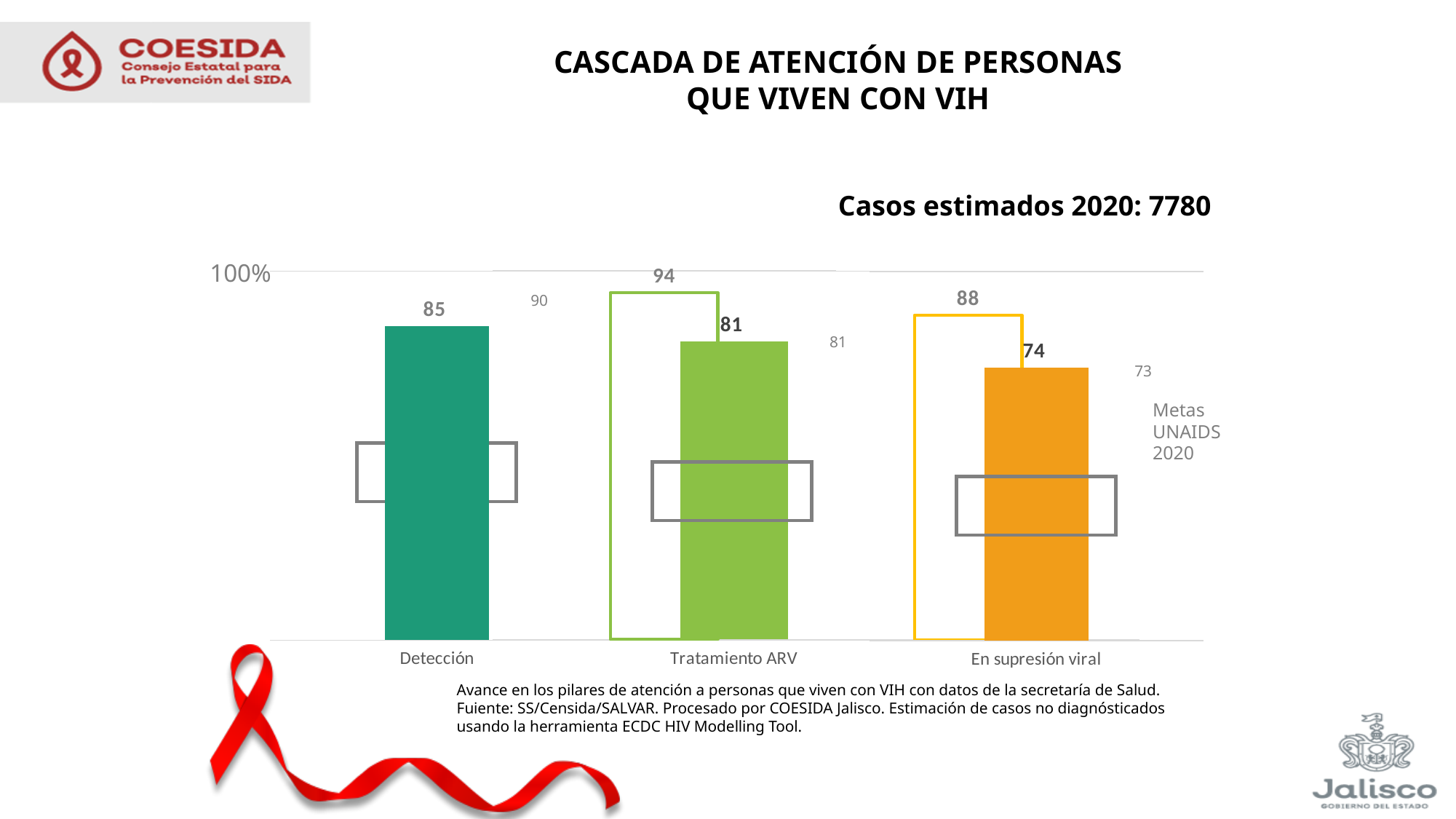
What value is shown on the outlined bar next to En supresión viral? 88 Do the filled bar values rise or fall from Detección to En supresión viral? Fall What is the value of the filled bar for En supresión viral? 74 How many categories are shown on the x axis? 3 Which filled bar is larger, Detección or Tratamiento ARV? Detección What kind of chart is shown on the slide? Bar chart What is the difference between the filled bar values for Detección and En supresión viral? 11 What is the value of the filled bar for Tratamiento ARV? 81 What is the value of the filled bar for Detección? 85 What value is shown on the outlined bar next to Tratamiento ARV? 94 Which category has the lowest filled bar? En supresión viral Which category has the highest filled bar? Detección